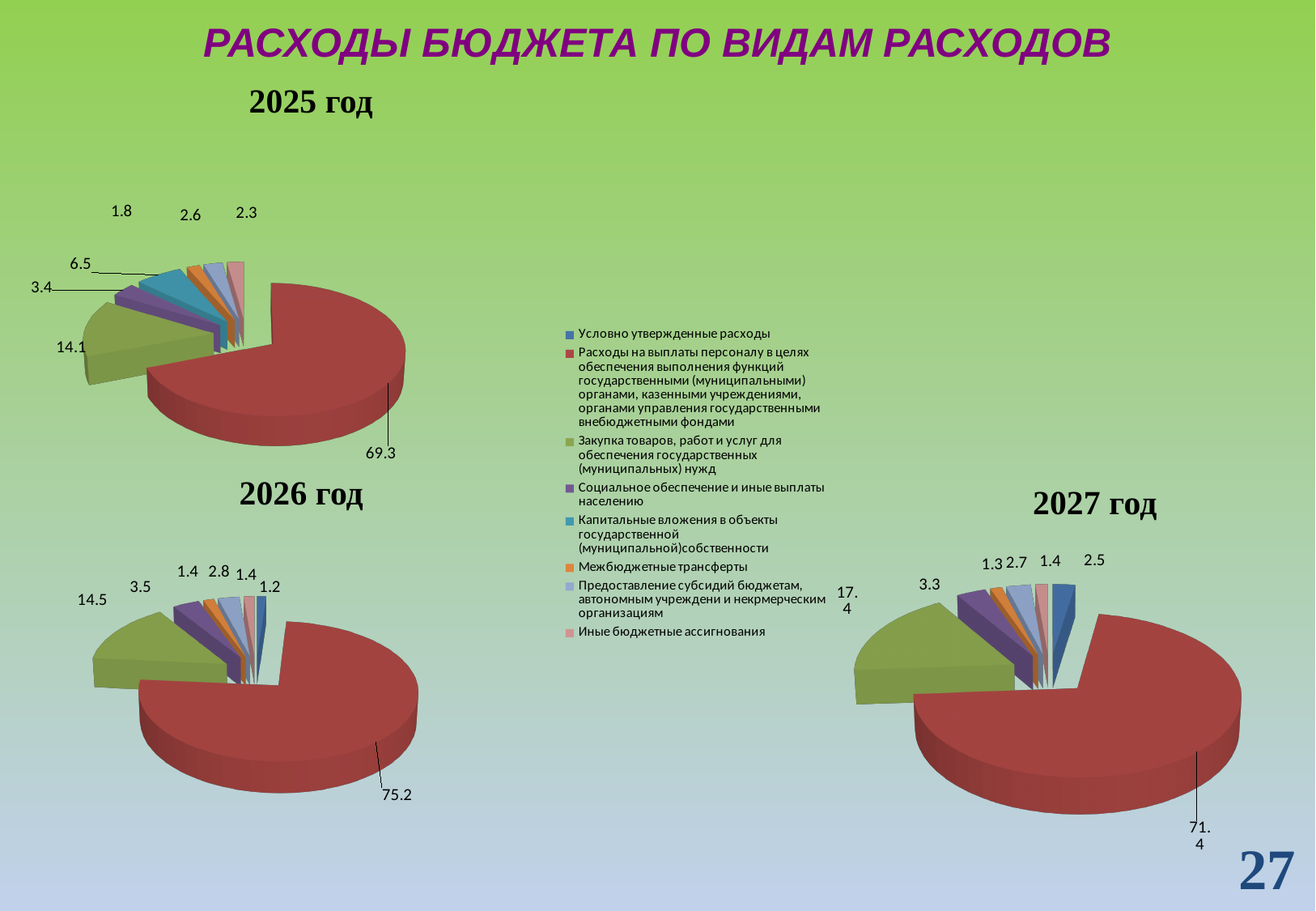
What is the difference between the largest slice in the 2026 год chart (75.2) and the largest slice in the 2025 год chart (69.3)? 5.9 In the 2025 год chart, what is the value of the green slice (Закупка товаров, работ и услуг)? 14.1 In the 2026 год chart, what is the value of the largest slice (Расходы на выплаты персоналу)? 75.2 In the 2025 год chart, what is the value of the largest slice (Расходы на выплаты персоналу)? 69.3 What kind of chart is used for the 2025 год chart? pie chart Which year's chart shows the highest value for Расходы на выплаты персоналу? 2026 год What is the smallest value labelled on the 2025 год chart? 1.8 How many entries does the legend list? 8 Is the green slice (Закупка товаров, работ и услуг) larger in the 2027 год chart or the 2025 год chart? 2027 год In the 2027 год chart, what is the value of the largest slice (Расходы на выплаты персоналу)? 71.4 In the 2026 год chart, what is the value of the green slice (Закупка товаров, работ и услуг)? 14.5 In the 2027 год chart, what is the value of the green slice (Закупка товаров, работ и услуг)? 17.4